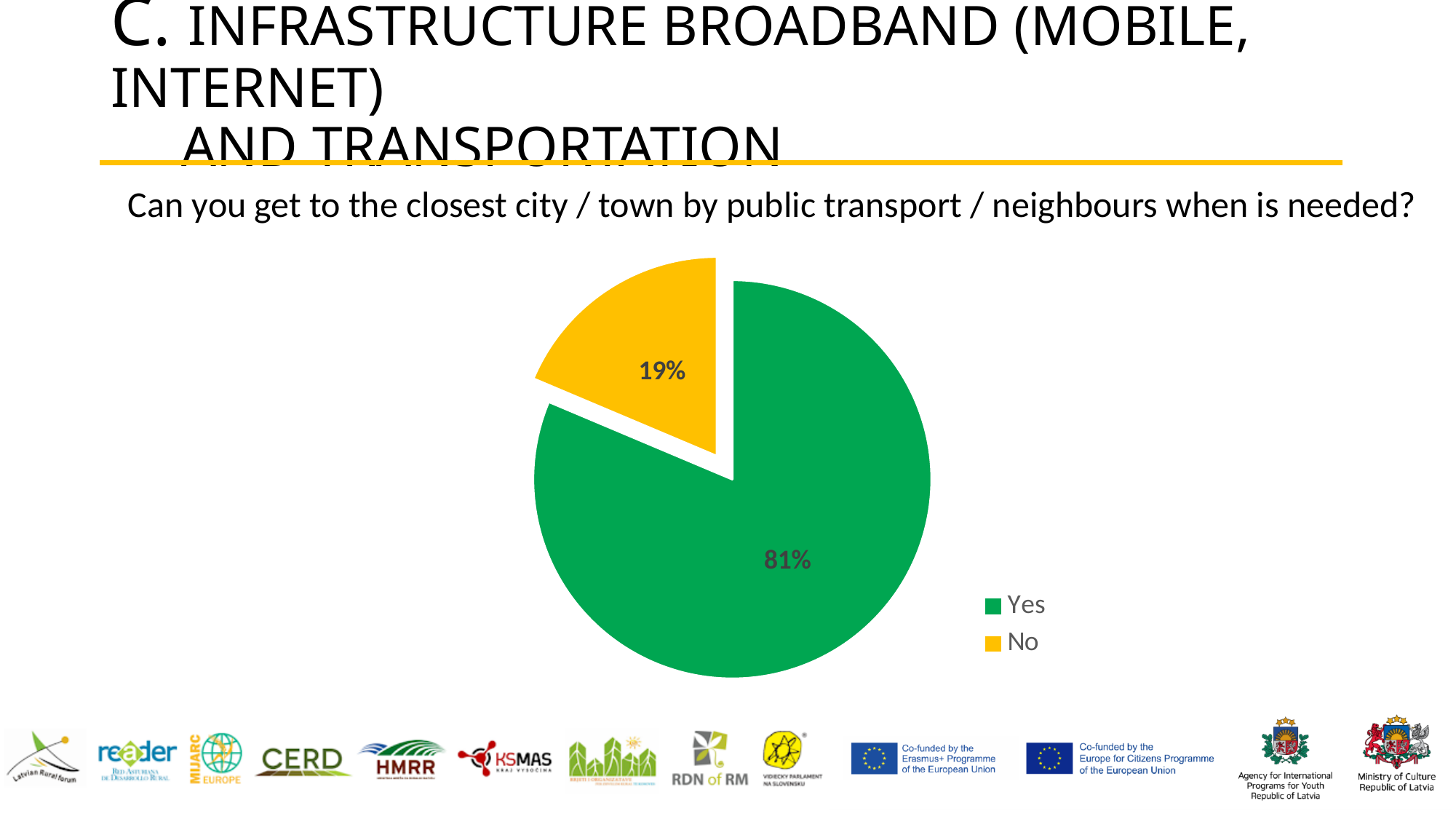
What colour is the No slice? yellow Which response has the smallest share of the pie? No Which response has the largest share of the pie? Yes What is the difference in percentage points between the Yes and No slices? 62 How many entries does the legend list? 2 How many slices does the pie chart have? 2 What percentage of respondents answered No? 19% What colour is the Yes slice? green Which slice is larger, Yes or No? Yes What percentage of respondents answered Yes? 81% What kind of chart is shown on the slide? pie chart What share of the pie does the No slice represent? 19%